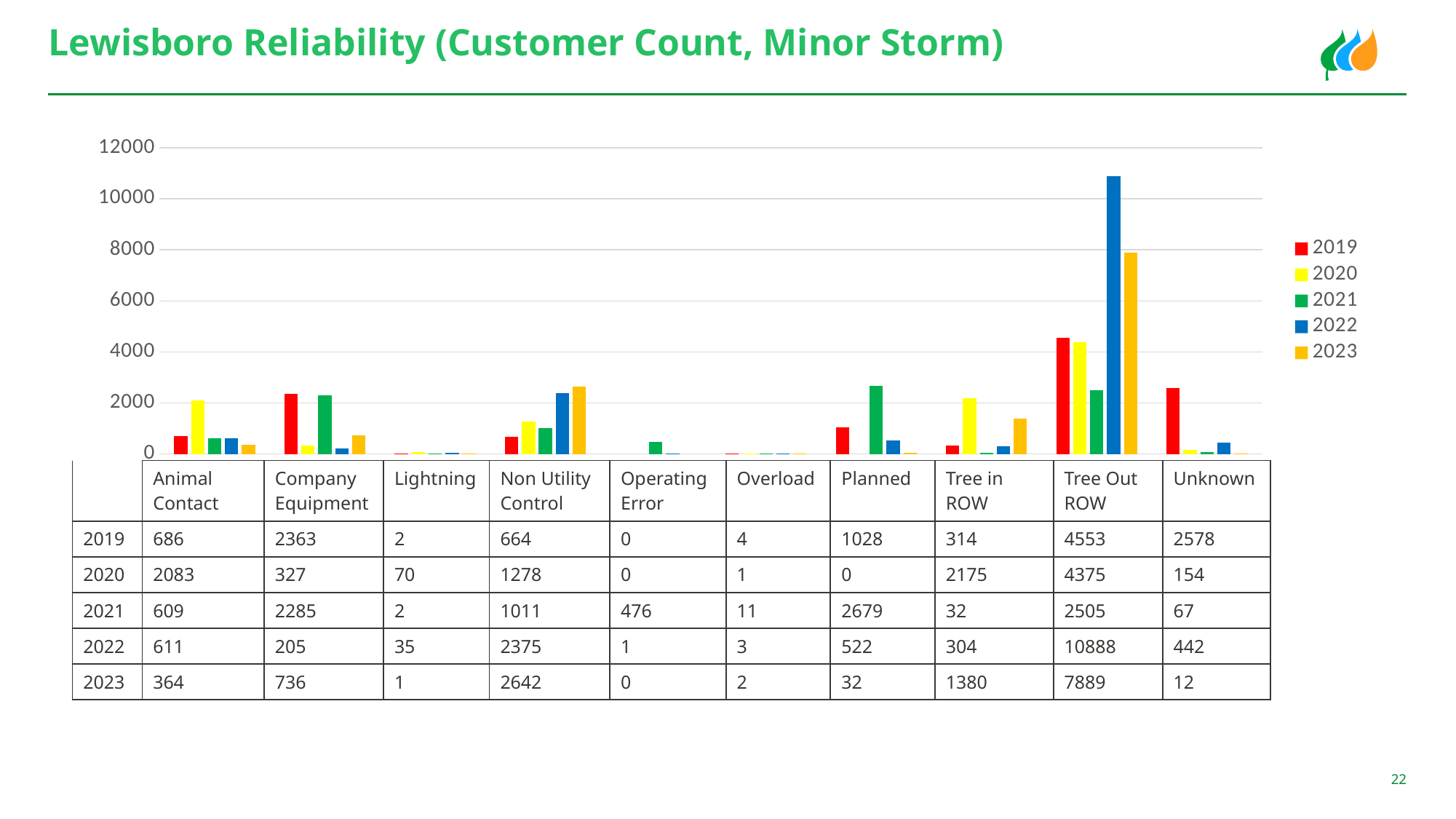
What is the 2021 value for Planned? 2679 Which is larger for Company Equipment: the 2019 value or the 2021 value? 2019 What is the 2020 value for Animal Contact? 2083 Which category has the highest 2023 value? Tree Out ROW Is the 2022 value for Tree Out ROW greater or less than 10000? greater What kind of chart is shown on the slide? bar chart What is the difference between the 2022 and 2023 values for Tree Out ROW? 2999 What is the 2022 value for Tree Out ROW? 10888 How many categories are shown on the x axis? 10 How many series does the legend list? 5 What is the title of the slide? Lewisboro Reliability (Customer Count, Minor Storm) Which category has the lowest 2019 value? Operating Error